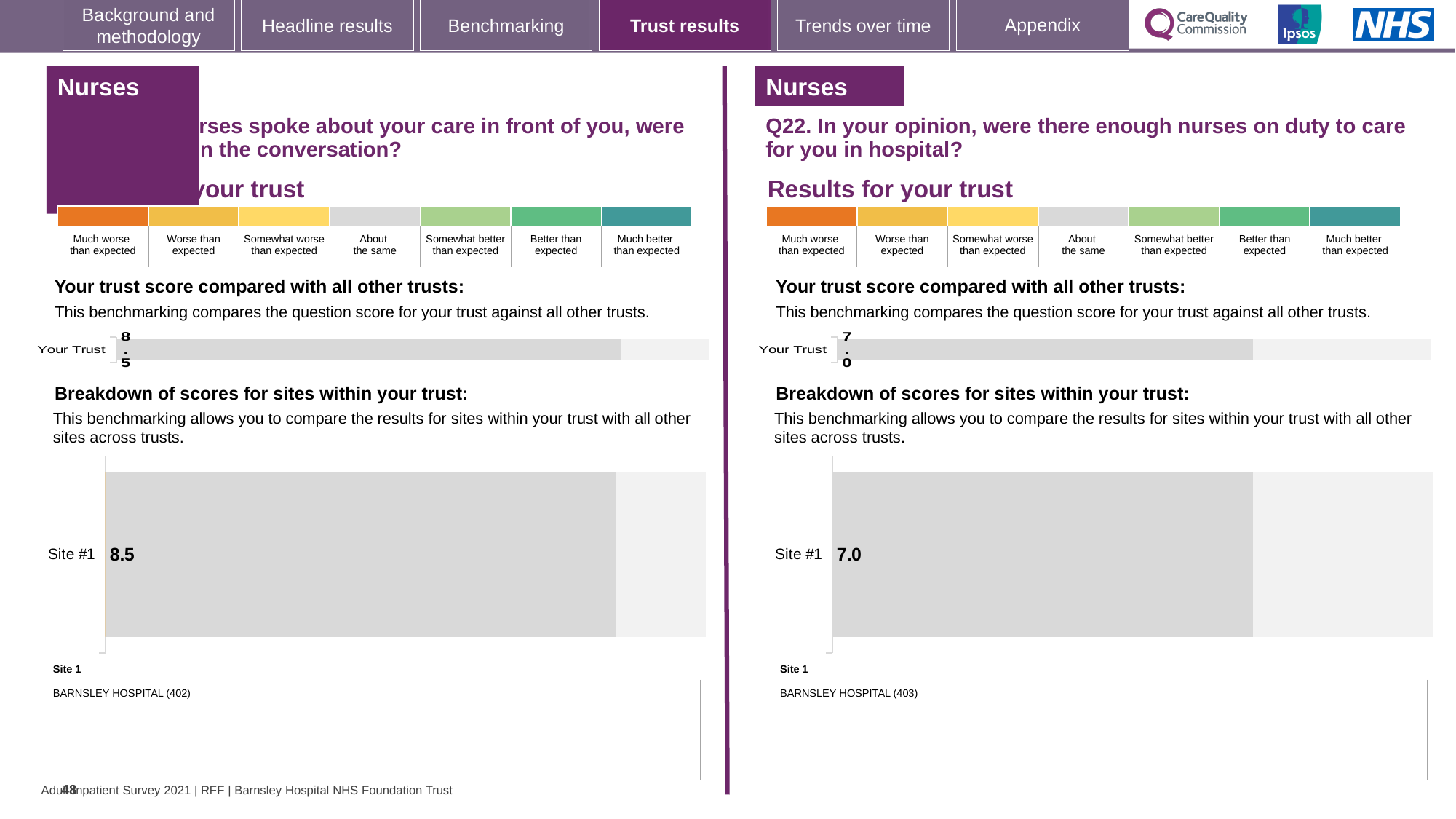
Which is larger: the Site #1 score in the left-hand breakdown chart or the Site #1 score in the right-hand (Q22) breakdown chart? Left-hand Site #1 (8.5) How many sites are plotted in the right-hand (Q22) 'Breakdown of scores for sites within your trust' chart? 1 In the left-hand breakdown chart, which hospital does Site 1 refer to? BARNSLEY HOSPITAL (402) On the right-hand side (Q22), what is the score shown for Site #1 in the 'Breakdown of scores for sites within your trust' chart? 7.0 Is the Your Trust score on the right-hand side (Q22) greater or less than the Your Trust score on the left-hand side? less On the right-hand side (Q22), what is the score shown for Your Trust in the 'Your trust score compared with all other trusts' chart? 7.0 What kind of chart is used to show the Site #1 score in the right-hand (Q22) 'Breakdown of scores for sites within your trust' section? Bar chart On the left-hand side of the slide, what is the score shown for Site #1 in the 'Breakdown of scores for sites within your trust' chart? 8.5 In the right-hand (Q22) breakdown chart, which hospital does Site 1 refer to? BARNSLEY HOSPITAL (403) How many sites are plotted in the left-hand 'Breakdown of scores for sites within your trust' chart? 1 What is the difference between the Your Trust score on the left-hand side (8.5) and the Your Trust score on the right-hand side (7.0)? 1.5 On the left-hand side of the slide, what is the score shown for Your Trust in the 'Your trust score compared with all other trusts' chart? 8.5